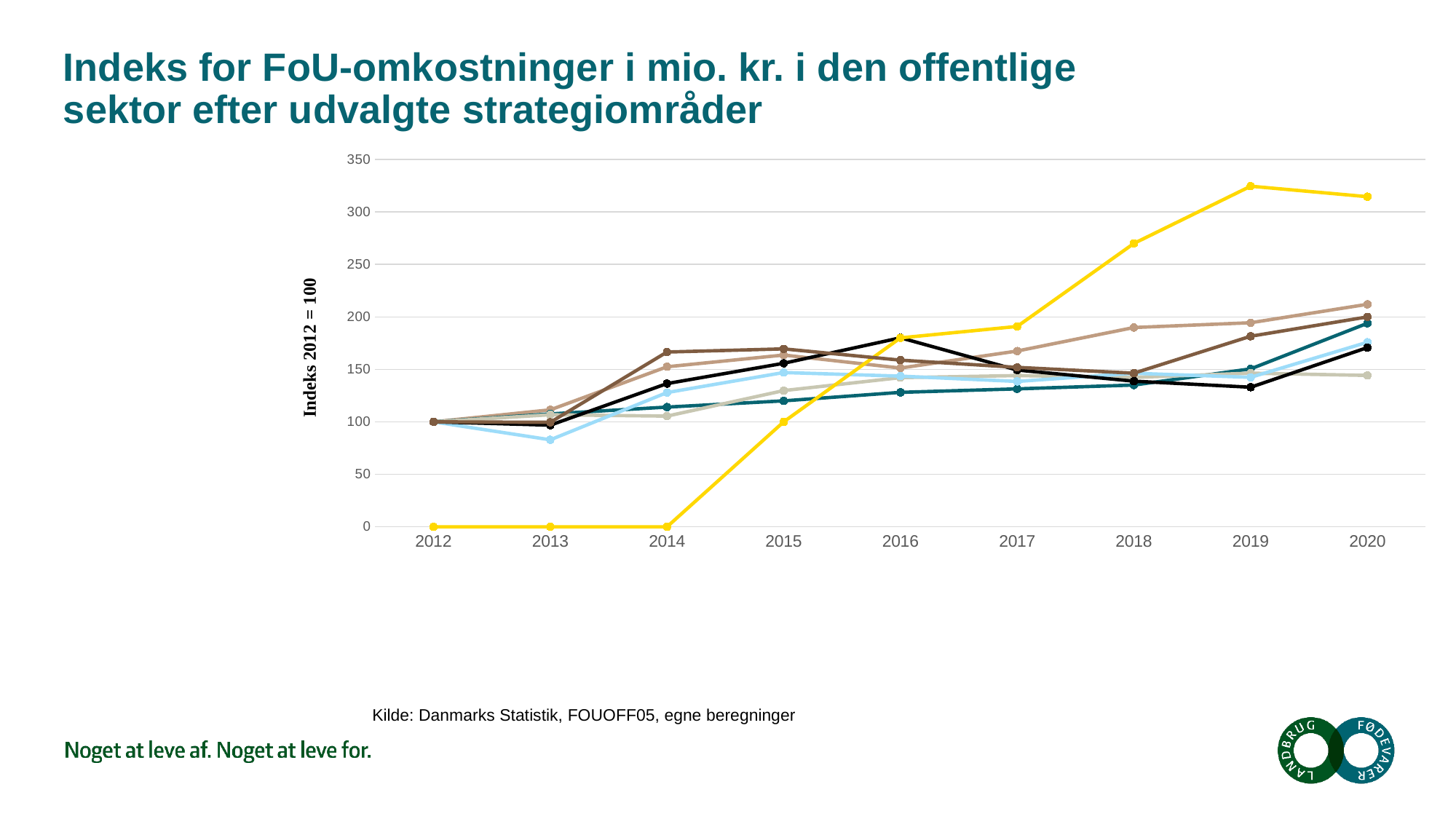
Does the yellow line rise or fall between 2014 and 2019? rise What kind of chart is shown on the slide? line chart What is the value of the yellow line in 2014? 0 Is the value of the yellow line in 2018 greater or less than 250? greater Which line has the highest value in 2020? the yellow line What is the label on the y axis of the chart? Indeks 2012 = 100 What is the last year shown on the x axis? 2020 How many years are shown along the x axis of the chart? 9 In which year does the yellow line reach its highest value? 2019 What is the first year shown on the x axis? 2012 Is the value of the yellow line in 2019 greater or less than 300? greater